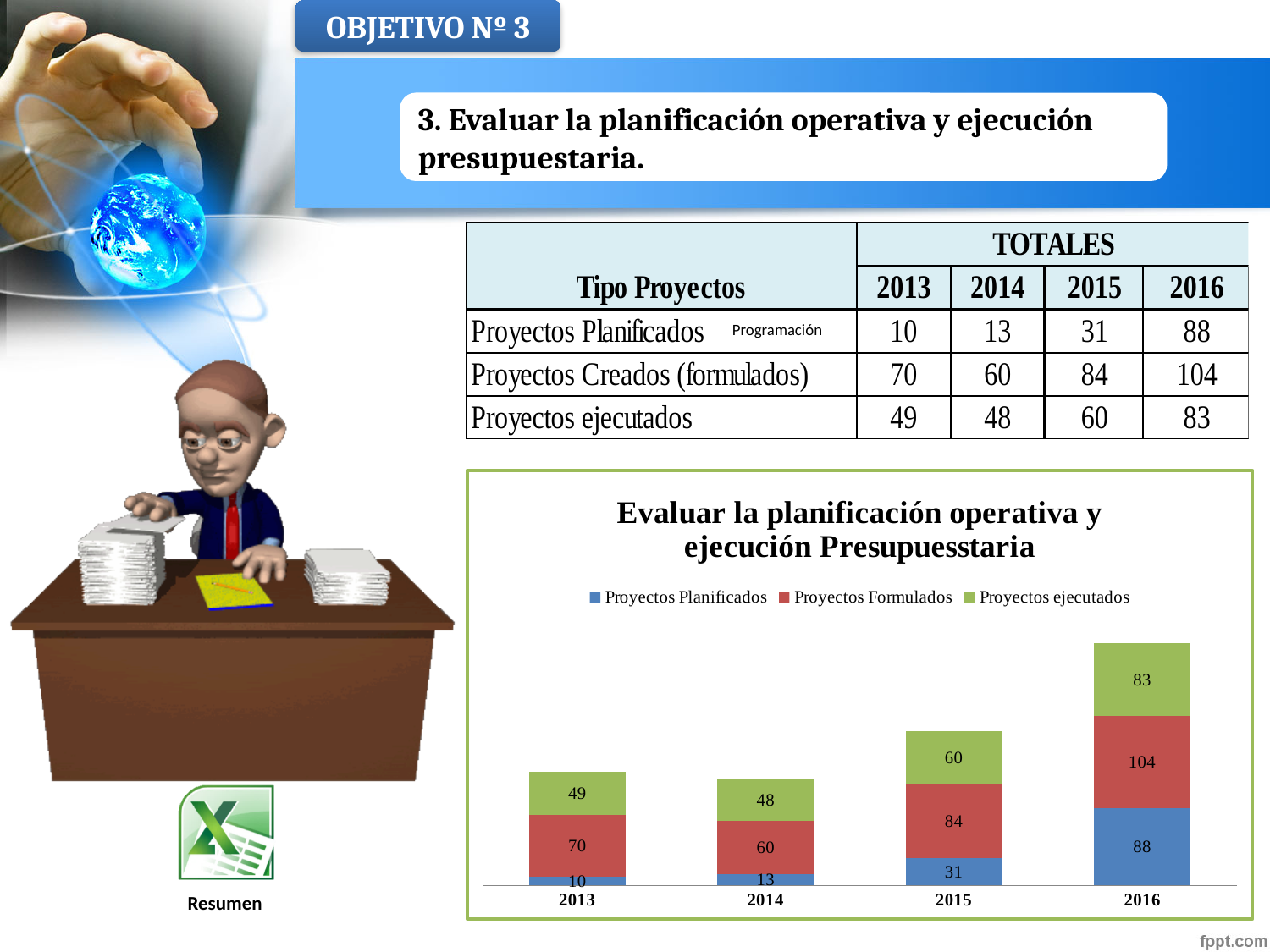
What type of chart is shown on the slide? Stacked bar chart Which is larger: Proyectos ejecutados in 2013 or Proyectos ejecutados in 2015? Proyectos ejecutados in 2015 What is the value of Proyectos Planificados for 2016? 88 What is the value of Proyectos ejecutados for 2014? 48 Which year has the lowest value for Proyectos Formulados? 2014 How many series does the chart legend list? 3 What is the difference between Proyectos Formulados in 2016 and in 2013? 34 Which year has the highest value for Proyectos Planificados? 2016 Do the values for Proyectos Planificados rise or fall from 2013 to 2016? Rise What is the total of the stacked bar for 2016? 275 What is the value of Proyectos Formulados for 2015? 84 How many years are shown on the x axis of the chart? 4